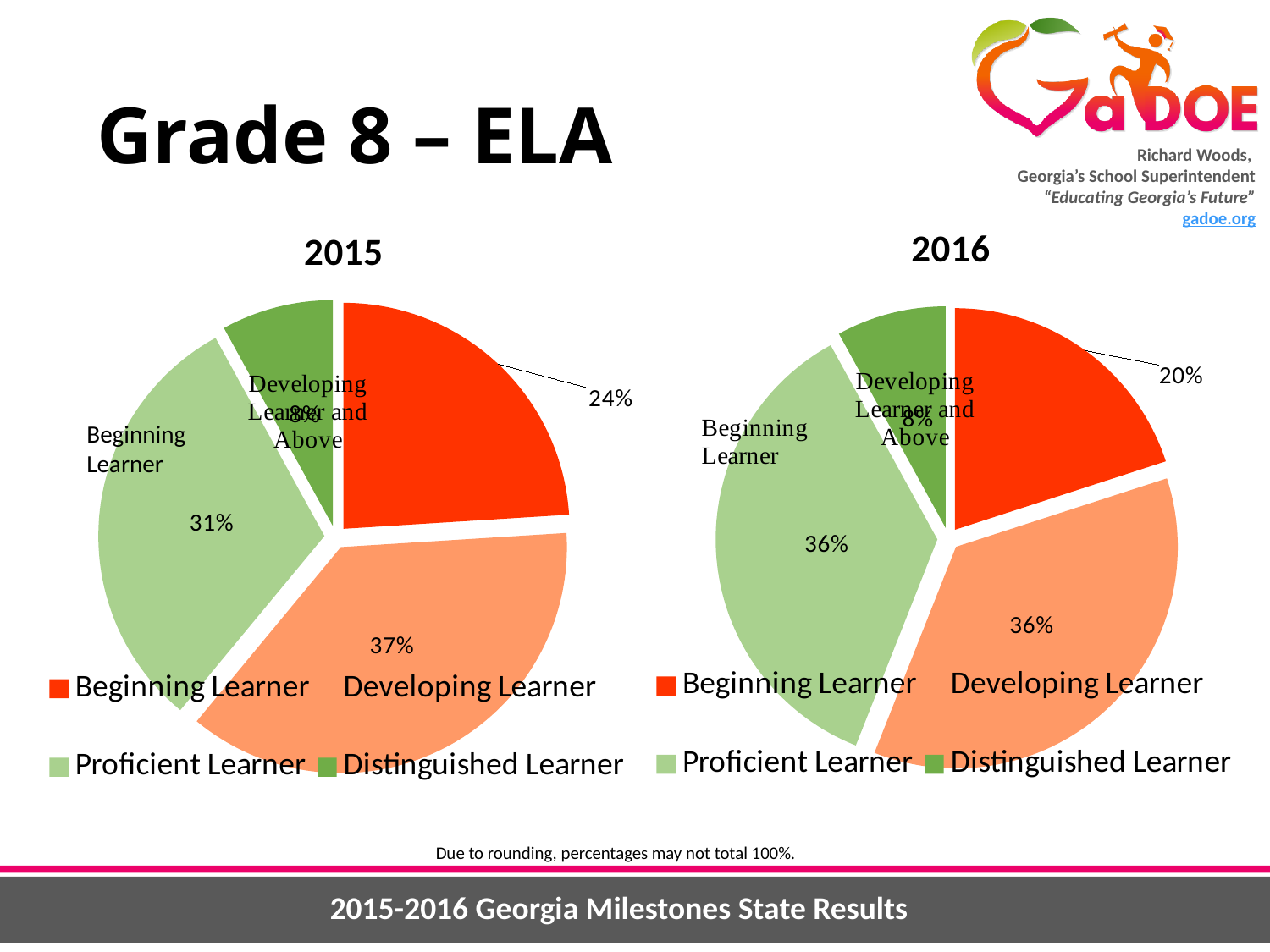
What type of chart is used for the 2015 chart? pie chart In the 2015 chart, what percentage is shown for Developing Learner? 37% In the 2015 chart, what percentage is shown for Beginning Learner? 24% In the 2016 chart, what percentage is shown for Beginning Learner? 20% In the 2015 chart, which category has the smallest share? Distinguished Learner In the 2015 chart, which is larger: Beginning Learner or Proficient Learner? Proficient Learner In the 2015 chart, what is the difference between the Developing Learner and Proficient Learner percentages? 6 percentage points By how many percentage points did the Beginning Learner share fall from the 2015 chart to the 2016 chart? 4 percentage points In the 2016 chart, which category has the smallest share? Distinguished Learner In the 2016 chart, what percentage is shown for Proficient Learner? 36% How many categories does the legend of the 2016 chart list? 4 In the 2015 chart, which category has the largest share? Developing Learner